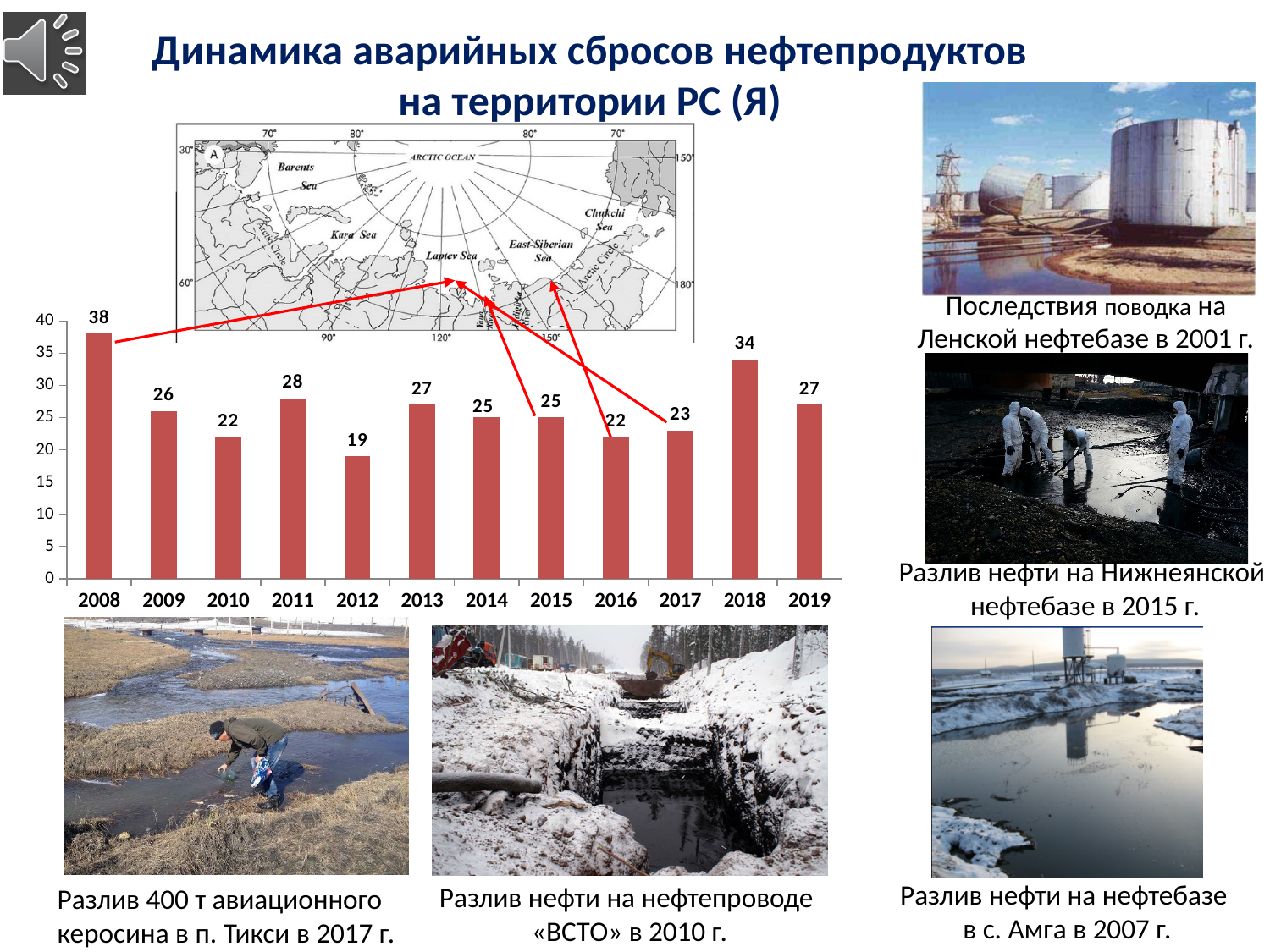
What is the value for 2008? 38 How many years are shown on the x axis? 12 What is the value for 2018? 34 What is the value for 2012? 19 What kind of chart is shown on the slide? bar chart What is the difference between the values for 2018 and 2019? 7 Which is larger, the value for 2011 or the value for 2017? 2011 Which year has the highest value? 2008 What is the difference between the values for 2008 and 2012? 19 Do the values rise or fall from 2017 to 2018? rise Is the value for 2018 greater or less than 30? greater Which year has the lowest value? 2012